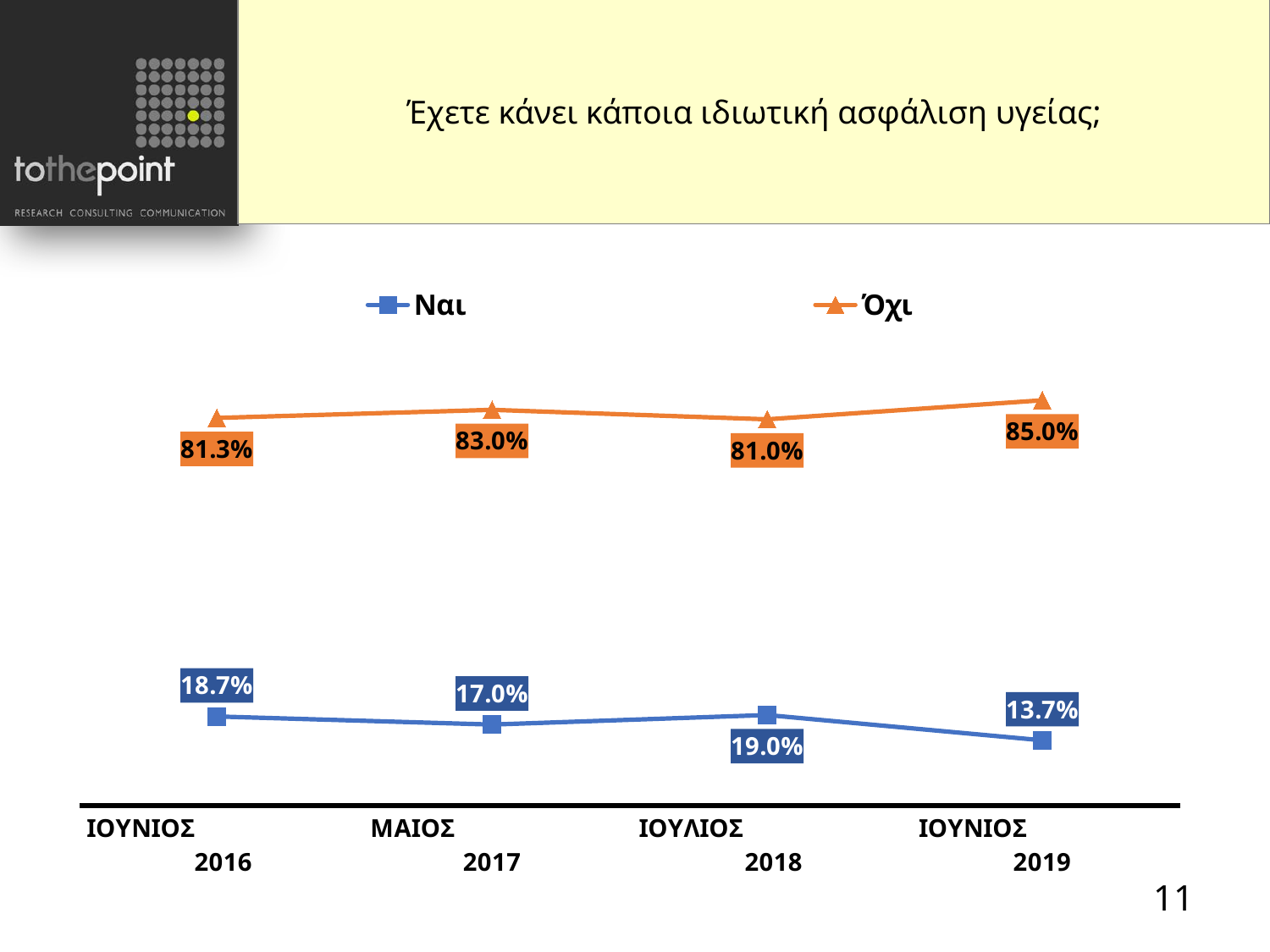
In which period is the Ναι series lowest? ΙΟΥΝΙΟΣ 2019 Which is larger: the Ναι value in ΜΑΙΟΣ 2017 or in ΙΟΥΛΙΟΣ 2018? ΙΟΥΛΙΟΣ 2018 What kind of chart is shown on the slide? Line chart How many time periods are shown on the x axis? 4 In which period is the Όχι series highest? ΙΟΥΝΙΟΣ 2019 What is the value for Ναι in ΙΟΥΛΙΟΣ 2018? 19.0% What is the difference between the Ναι values for ΙΟΥΝΙΟΣ 2016 and ΙΟΥΝΙΟΣ 2019? 5.0% What is the difference between the Όχι values for ΙΟΥΝΙΟΣ 2019 and ΙΟΥΛΙΟΣ 2018? 4.0% How many series does the legend list? 2 What is the value for Όχι in ΙΟΥΝΙΟΣ 2019? 85.0% What is the value for Όχι in ΜΑΙΟΣ 2017? 83.0% What is the value for Ναι in ΙΟΥΝΙΟΣ 2016? 18.7%